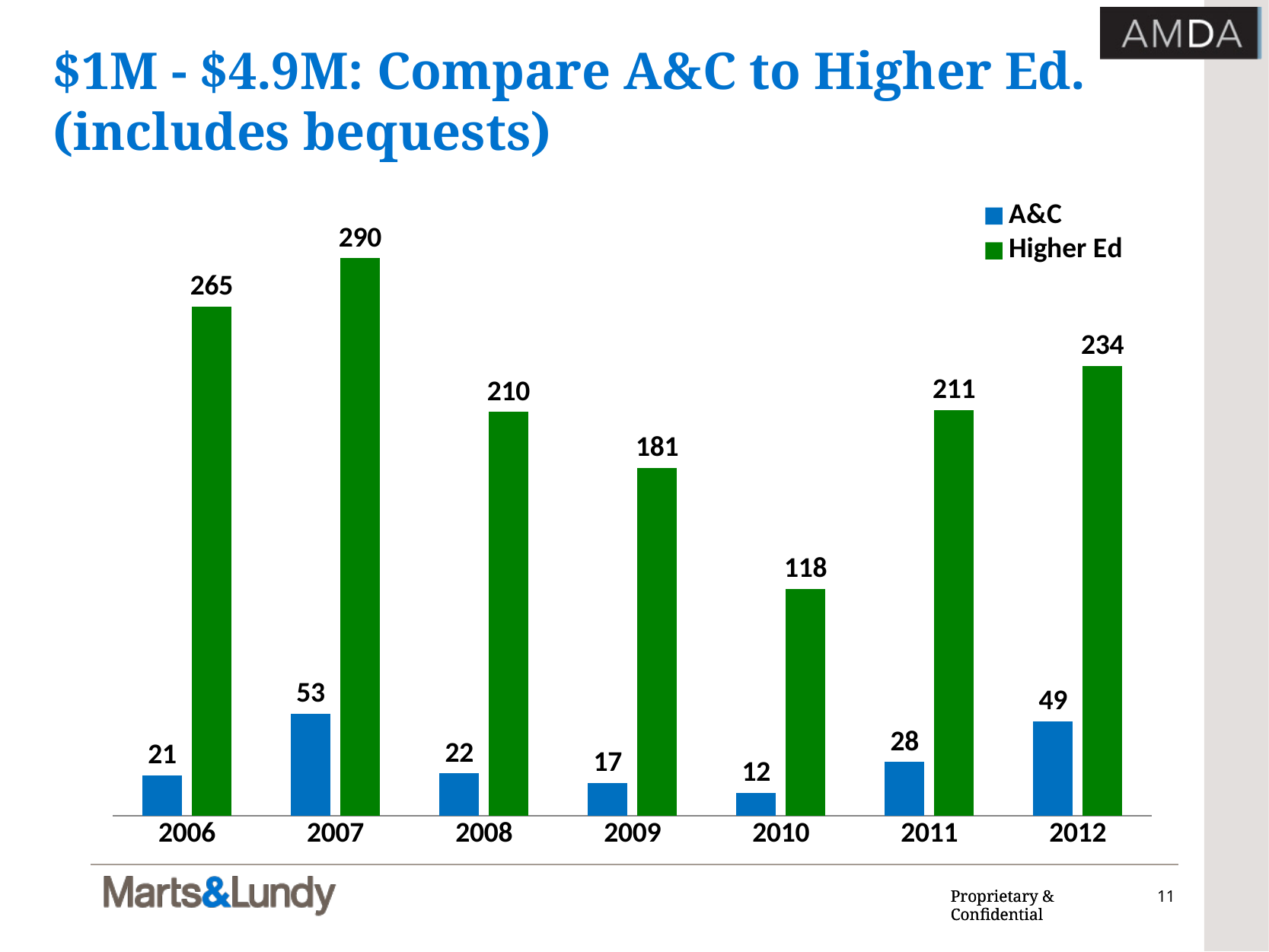
Which year has the lowest A&C value? 2010 Which year has the lowest Higher Ed value? 2010 What is the A&C value for 2010? 12 Which colour represents Higher Ed in the chart? Green What is the Higher Ed value for 2007? 290 What kind of chart is shown on the slide? Bar chart What is the difference between the Higher Ed and A&C values in 2006? 244 Which is larger, the A&C value for 2007 or the A&C value for 2012? 2007 What is the A&C value for 2012? 49 How many years are shown on the x axis? 7 Which year has the highest Higher Ed value? 2007 How many series does the legend list? 2